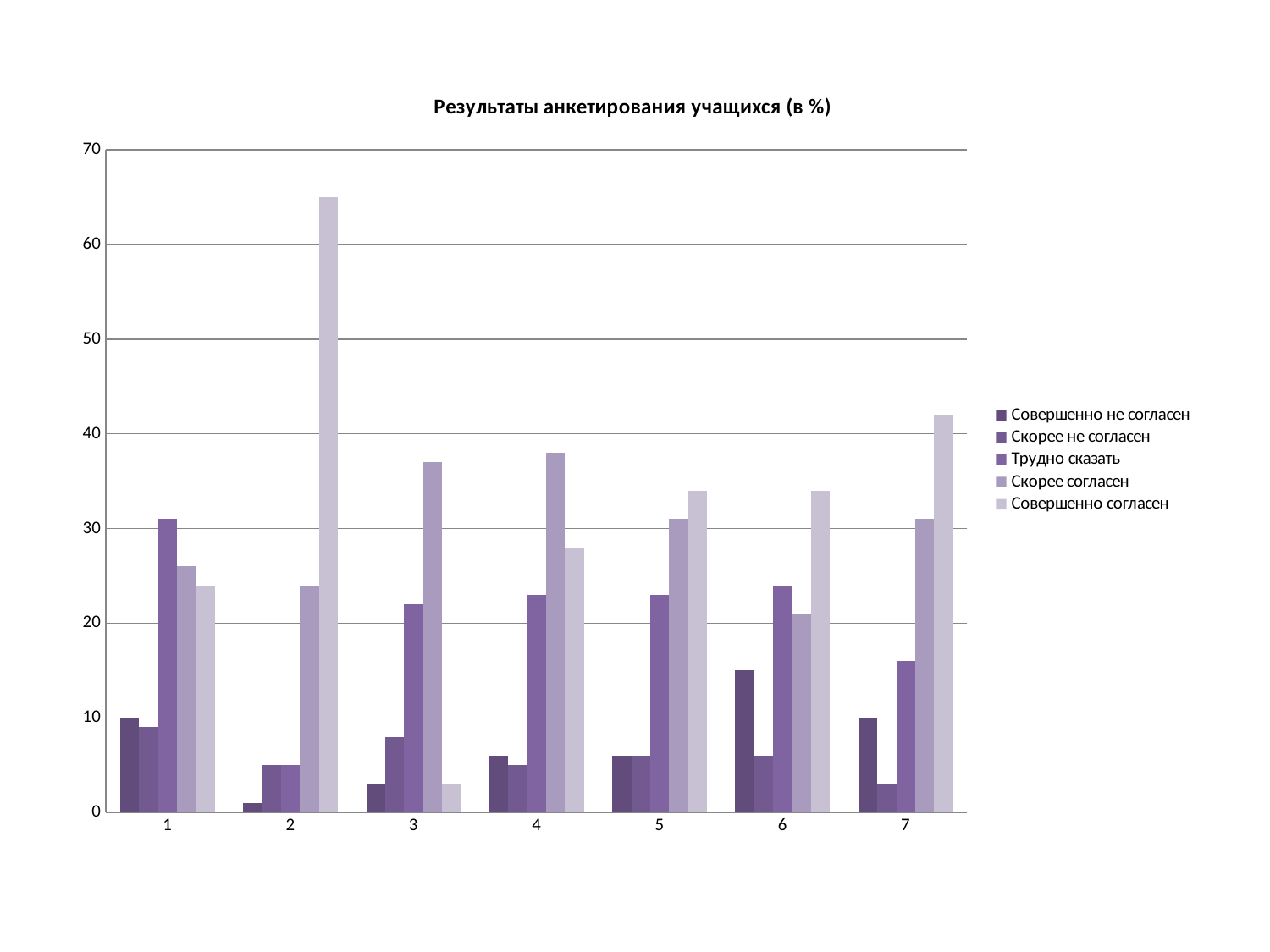
How many series does the legend list? 5 What is the title of the chart? Результаты анкетирования учащихся (в %) How many categories are shown on the x axis? 7 In category 6, which is larger: 'Скорее согласен' or 'Совершенно согласен'? Совершенно согласен In category 1, which is larger: 'Трудно сказать' or 'Совершенно согласен'? Трудно сказать For which category is the 'Совершенно согласен' bar the highest? 2 What kind of chart is shown on the slide? bar chart Is the value for 'Совершенно согласен' in category 3 greater or less than 10? less Is the value for 'Совершенно согласен' in category 2 greater or less than 60? greater For which category is the 'Совершенно согласен' bar the lowest? 3 Is the value for 'Совершенно согласен' in category 7 greater or less than 40? greater For which category is the 'Совершенно не согласен' bar the highest? 6